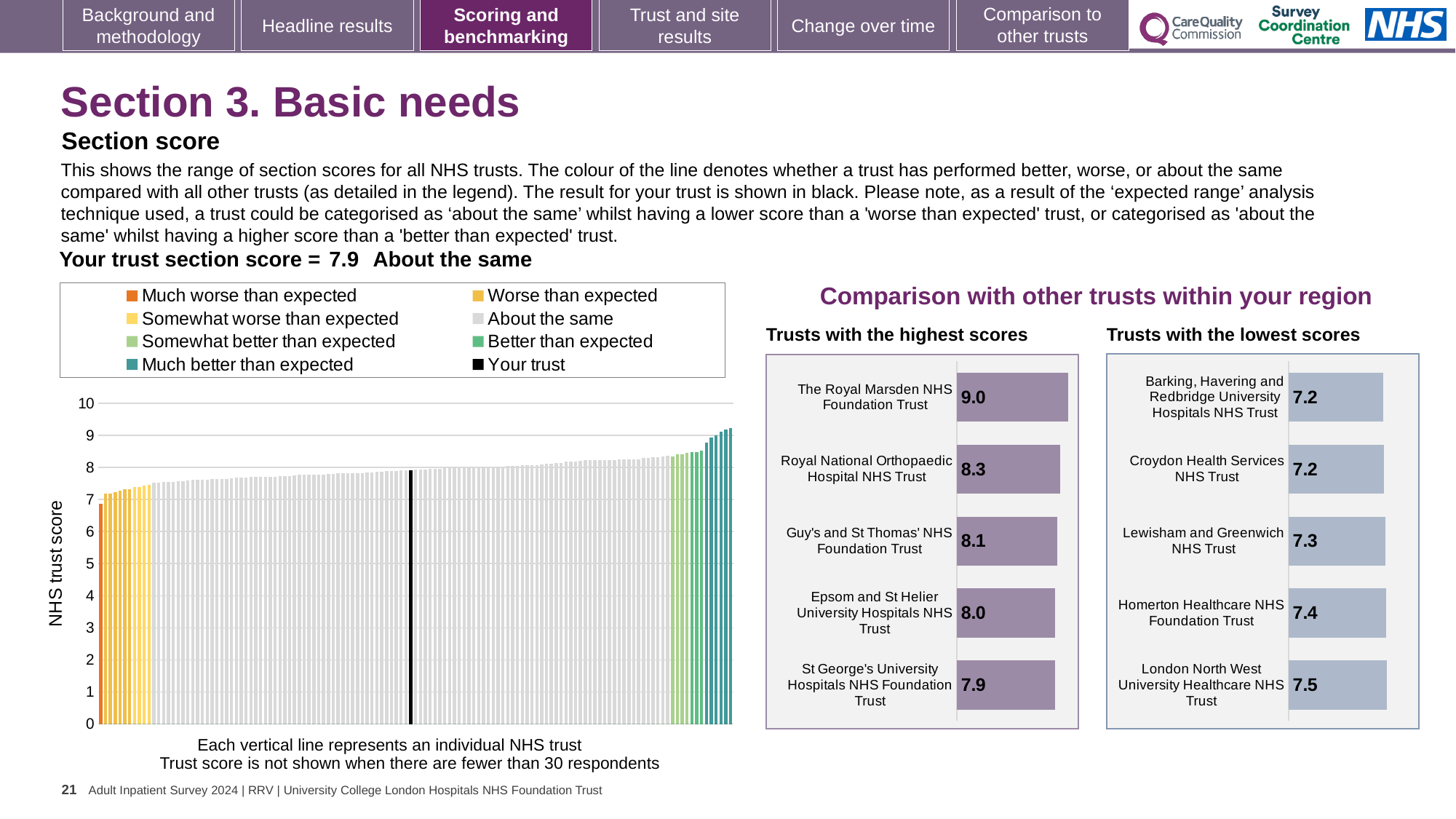
In the 'Trusts with the lowest scores' chart, which trust has the highest score? London North West University Healthcare NHS Trust What is the section score for your trust shown on the slide? 7.9 In the 'Trusts with the highest scores' chart, what is the score for The Royal Marsden NHS Foundation Trust? 9.0 What type of chart is the large chart on the left showing NHS trust scores? Bar chart In the 'Trusts with the highest scores' chart, which trust has the highest score? The Royal Marsden NHS Foundation Trust In the 'Trusts with the lowest scores' chart, what is the score for Homerton Healthcare NHS Foundation Trust? 7.4 In the 'Trusts with the lowest scores' chart, what is the difference between the scores of London North West University Healthcare NHS Trust and Croydon Health Services NHS Trust? 0.3 How many entries does the legend of the large chart on the left list? 8 In the 'Trusts with the highest scores' chart, what is the difference between the scores of The Royal Marsden NHS Foundation Trust and Royal National Orthopaedic Hospital NHS Trust? 0.7 In the 'Trusts with the highest scores' chart, how many trusts are shown? 5 In the large chart on the left, do the trust scores rise or fall from left to right? Rise In the 'Trusts with the lowest scores' chart, which has the larger score: Lewisham and Greenwich NHS Trust or Homerton Healthcare NHS Foundation Trust? Homerton Healthcare NHS Foundation Trust